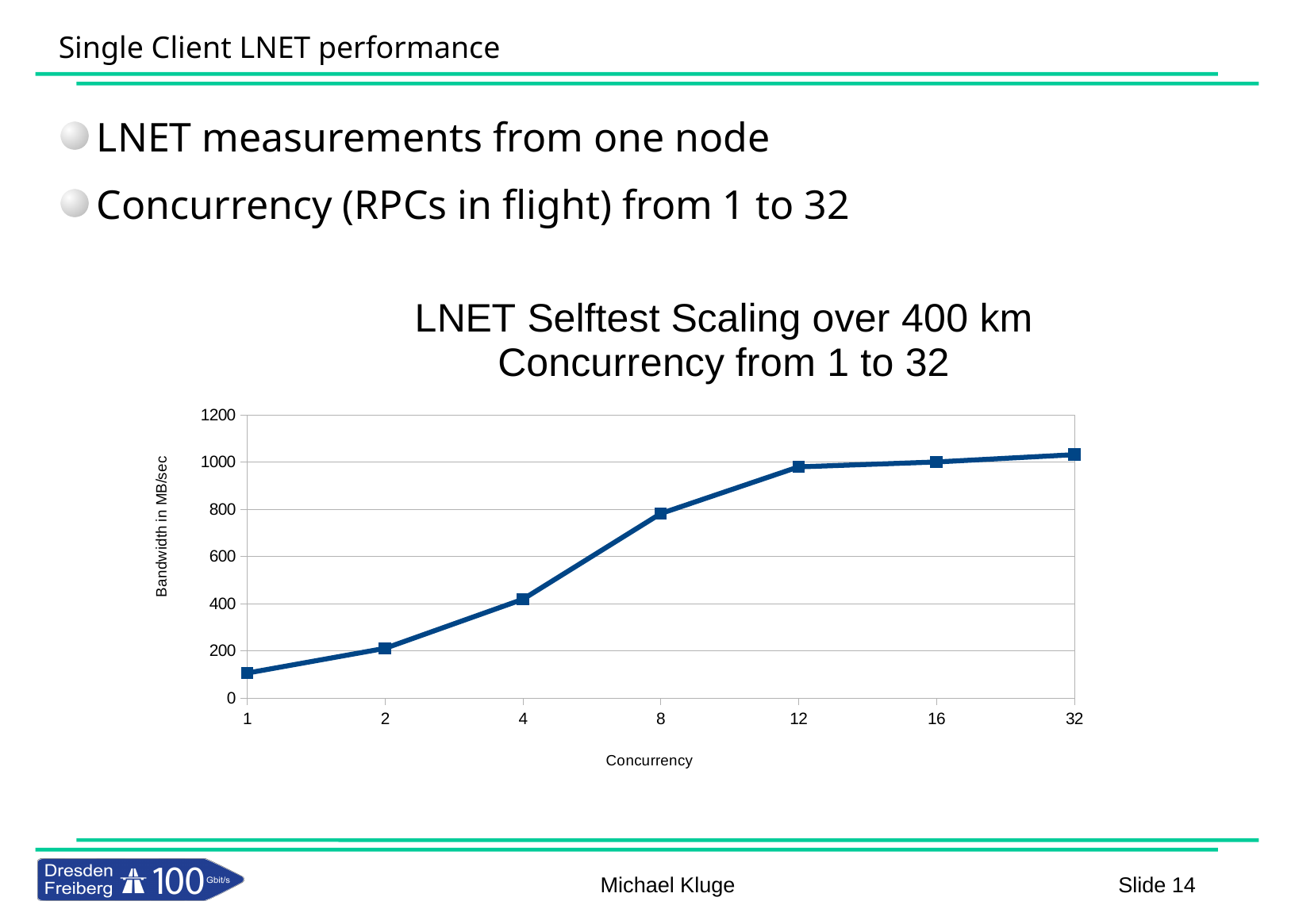
Is the bandwidth at concurrency 12 greater or less than 800 MB/sec? greater Is the bandwidth at concurrency 1 greater or less than 200 MB/sec? less Is the bandwidth at concurrency 4 greater or less than 600 MB/sec? less Does the bandwidth rise or fall as concurrency increases from 1 to 32? rise What is the label of the y axis of the chart? Bandwidth in MB/sec What is the title of the chart? LNET Selftest Scaling over 400 km Concurrency from 1 to 32 What kind of chart is shown on the slide? line chart How many data points are plotted on the chart? 7 Which has the higher bandwidth, concurrency 4 or concurrency 8? 8 Which has the higher bandwidth, concurrency 2 or concurrency 12? 12 Which concurrency value has the lowest bandwidth? 1